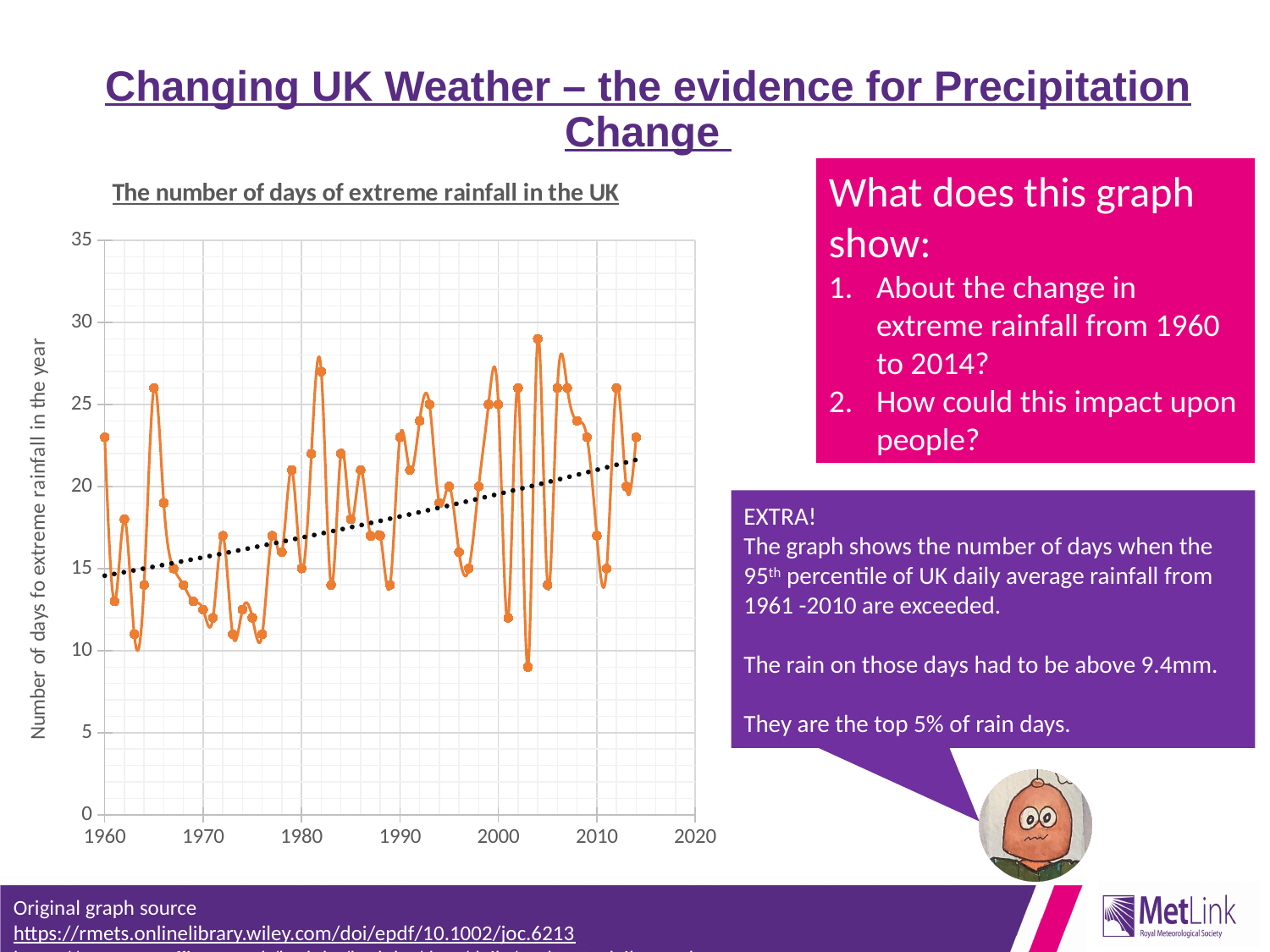
What is the label on the vertical axis of the chart? Number of days fo extreme rainfall in the year Which year has the larger value, 2003 or 2004? 2004 Which year has the larger value, 1960 or 1961? 1960 Which year has the highest number of days of extreme rainfall in the chart? 2004 What is the title of the chart? The number of days of extreme rainfall in the UK What kind of chart is shown on the slide? line chart Is the value for 2003 greater or less than 10? less Is the value for 1975 greater or less than 15? less Overall, do the values in the chart rise or fall from 1960 to 2014? rise Is the value for 2004 greater or less than 25? greater